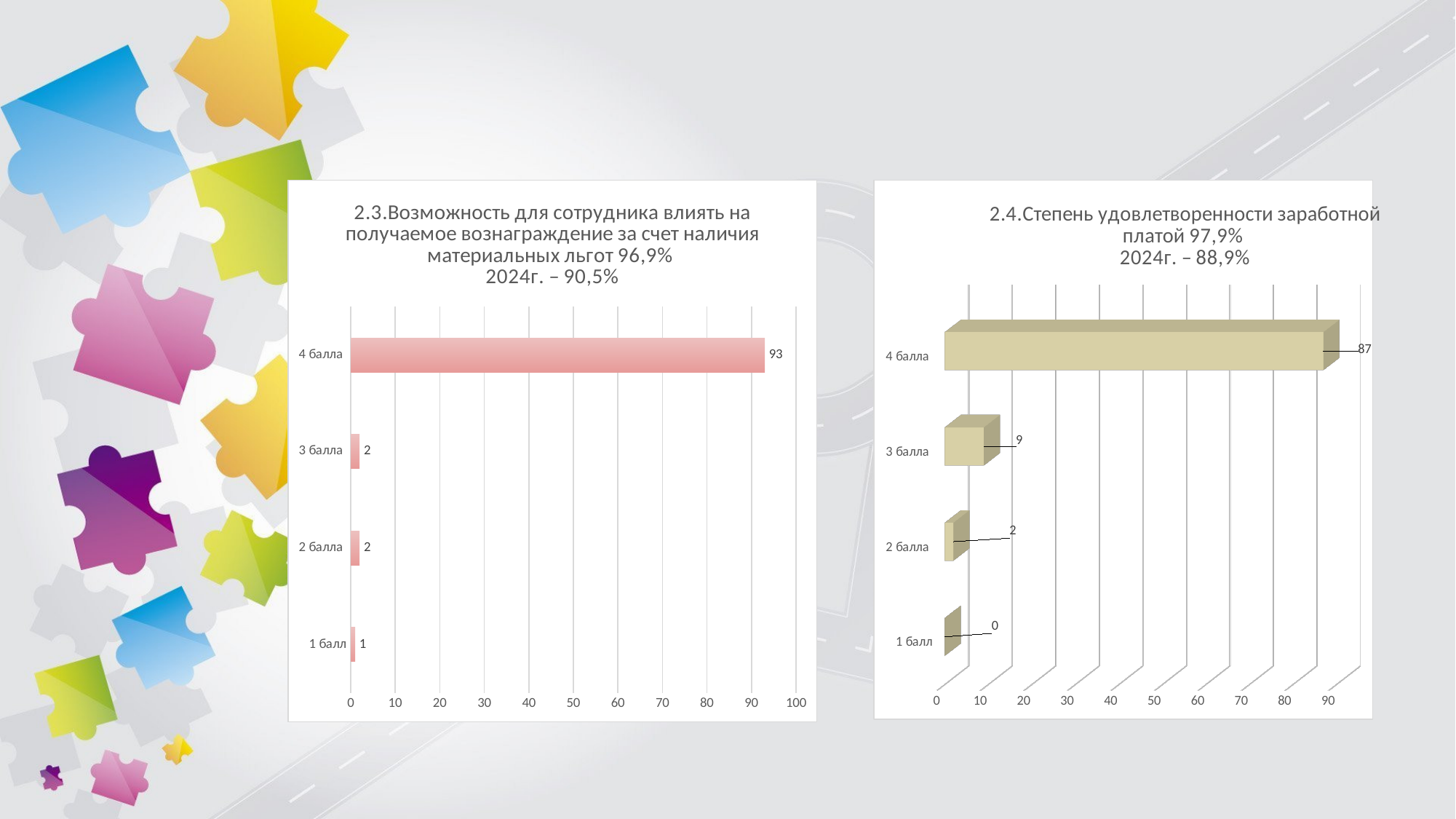
In the left chart (2.3), is the value for 4 балла greater or less than 90? greater In the right chart (2.4), what is the value for 3 балла? 9 Which is larger: the value for 4 балла in the left chart (2.3) or the value for 4 балла in the right chart (2.4)? Left chart (2.3), 93 In the right chart (2.4), what is the difference between the values for 4 балла and 3 балла? 78 What type of chart is the left chart (2.3)? Bar chart How many categories are shown in the right chart (2.4)? 4 What percentage for 2024г. is shown in the title of the right chart (2.4)? 88,9% In the left chart (2.3), which category has the highest value? 4 балла In the left chart (2.3), what is the difference between the values for 4 балла and 3 балла? 91 In the left chart (2.3), what is the value for 4 балла? 93 In the right chart (2.4), what is the value for 1 балл? 0 In the right chart (2.4), which category has the lowest value? 1 балл